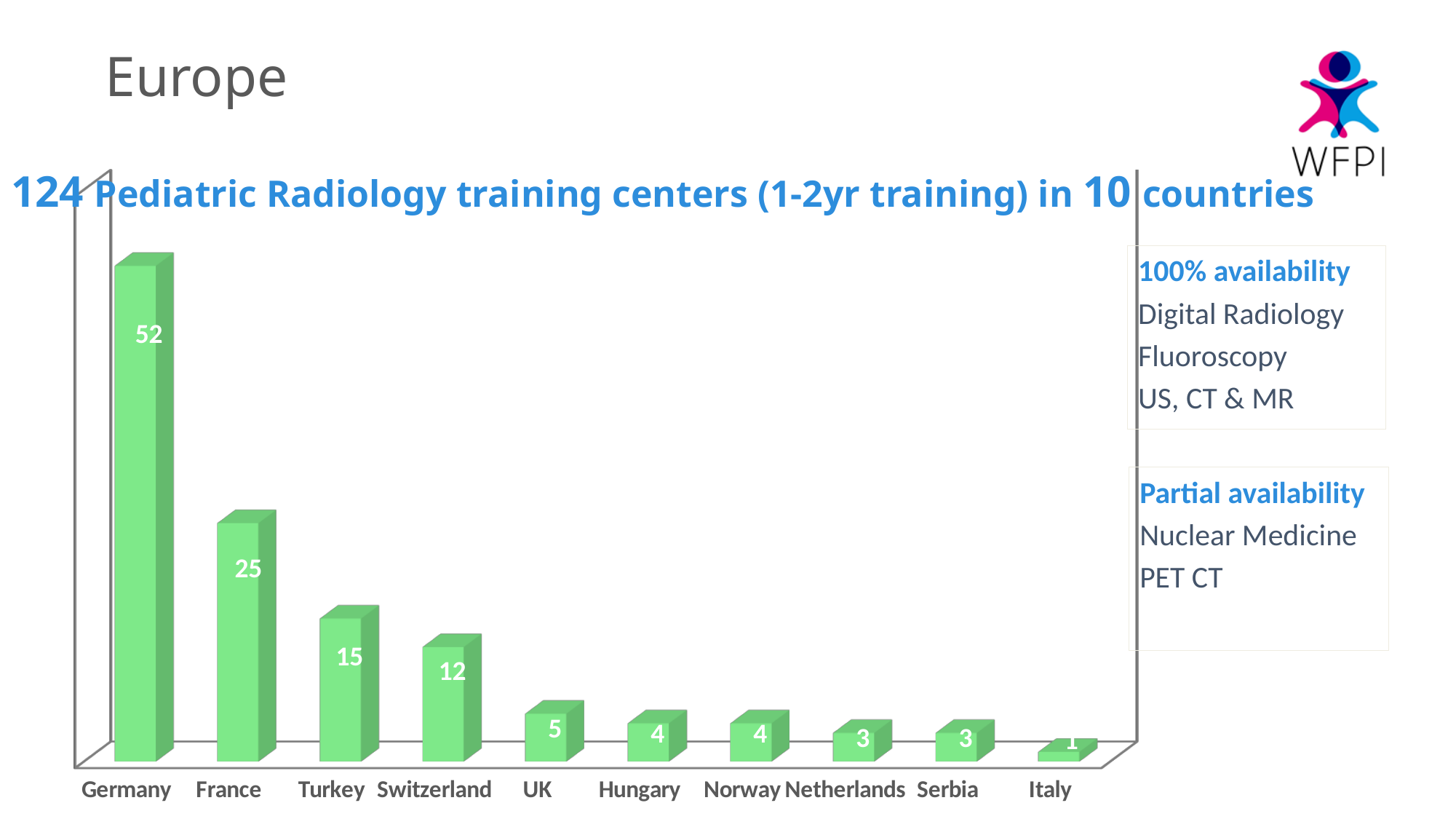
What is the value for Switzerland? 12 What is the value for Italy? 1 Which is larger, the value for Turkey or the value for Switzerland? Turkey Which country has the highest value? Germany How many countries are shown on the x axis? 10 What is the value for France? 25 Which country has the lowest value? Italy What is the difference between the values for Turkey and UK? 10 What kind of chart is shown on the slide? Bar chart What is the difference between the values for Germany and France? 27 What is the value for Germany? 52 Do the values rise or fall from left to right along the x axis? Fall